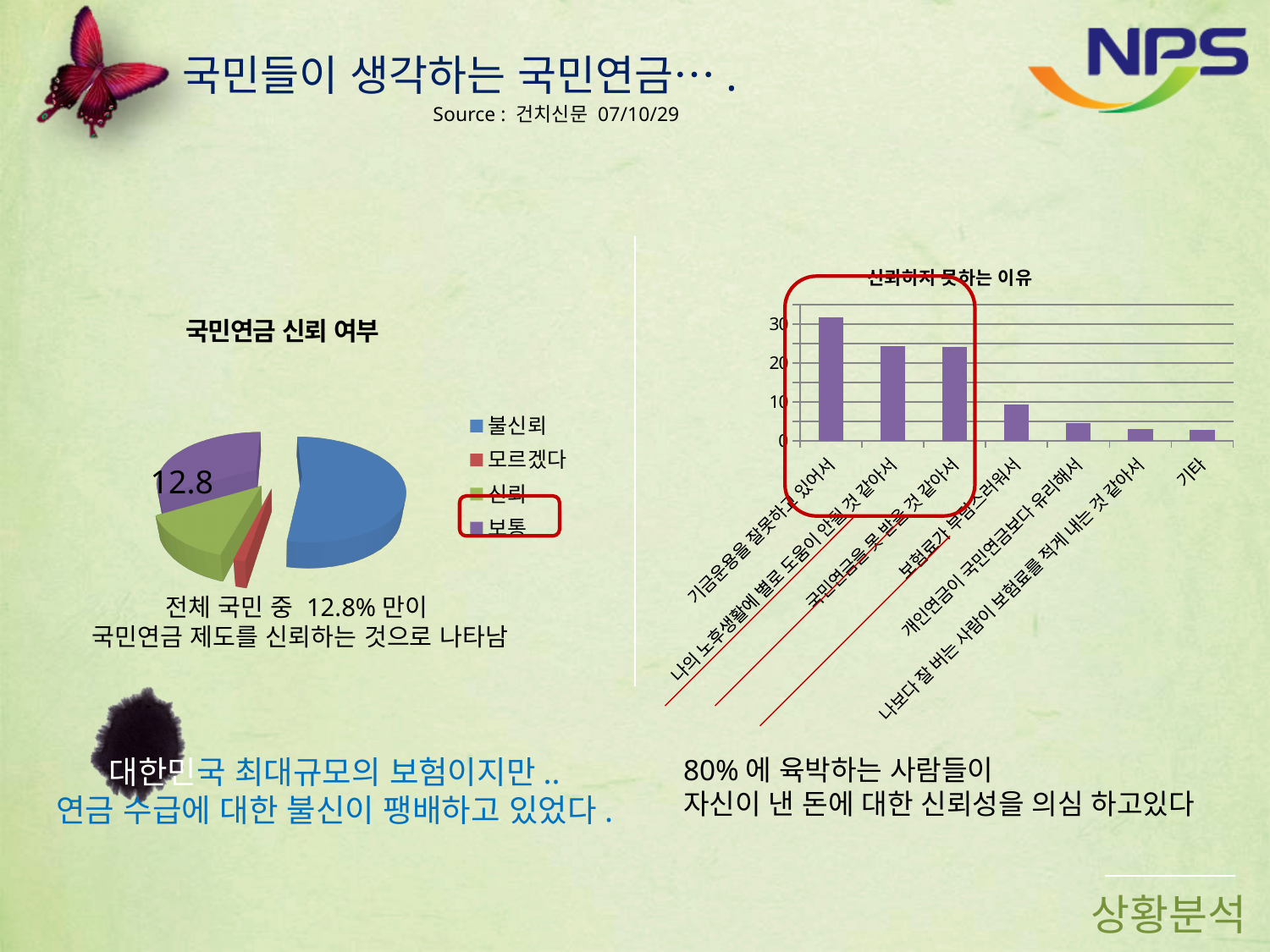
In the '신뢰하지 못하는 이유' bar chart, which is larger: the value for 보험료가 부담스러워서 or the value for 기타? 보험료가 부담스러워서 In the '신뢰하지 못하는 이유' bar chart, do the bar values generally rise or fall from left to right? fall How many categories are shown in the '신뢰하지 못하는 이유' bar chart? 7 In the '신뢰하지 못하는 이유' bar chart, is the value for 기타 greater or less than 10? less In the '국민연금 신뢰 여부' pie chart, what colour is the 불신뢰 slice? blue How many entries does the legend of the '국민연금 신뢰 여부' pie chart list? 4 In the '국민연금 신뢰 여부' pie chart, what value is printed on the 신뢰 slice? 12.8 In the '신뢰하지 못하는 이유' bar chart, is the value for the leftmost bar greater or less than 30? greater What kind of chart is the '신뢰하지 못하는 이유' chart? bar chart In the '국민연금 신뢰 여부' pie chart, which category has the largest slice? 불신뢰 What kind of chart is the '국민연금 신뢰 여부' chart? pie chart